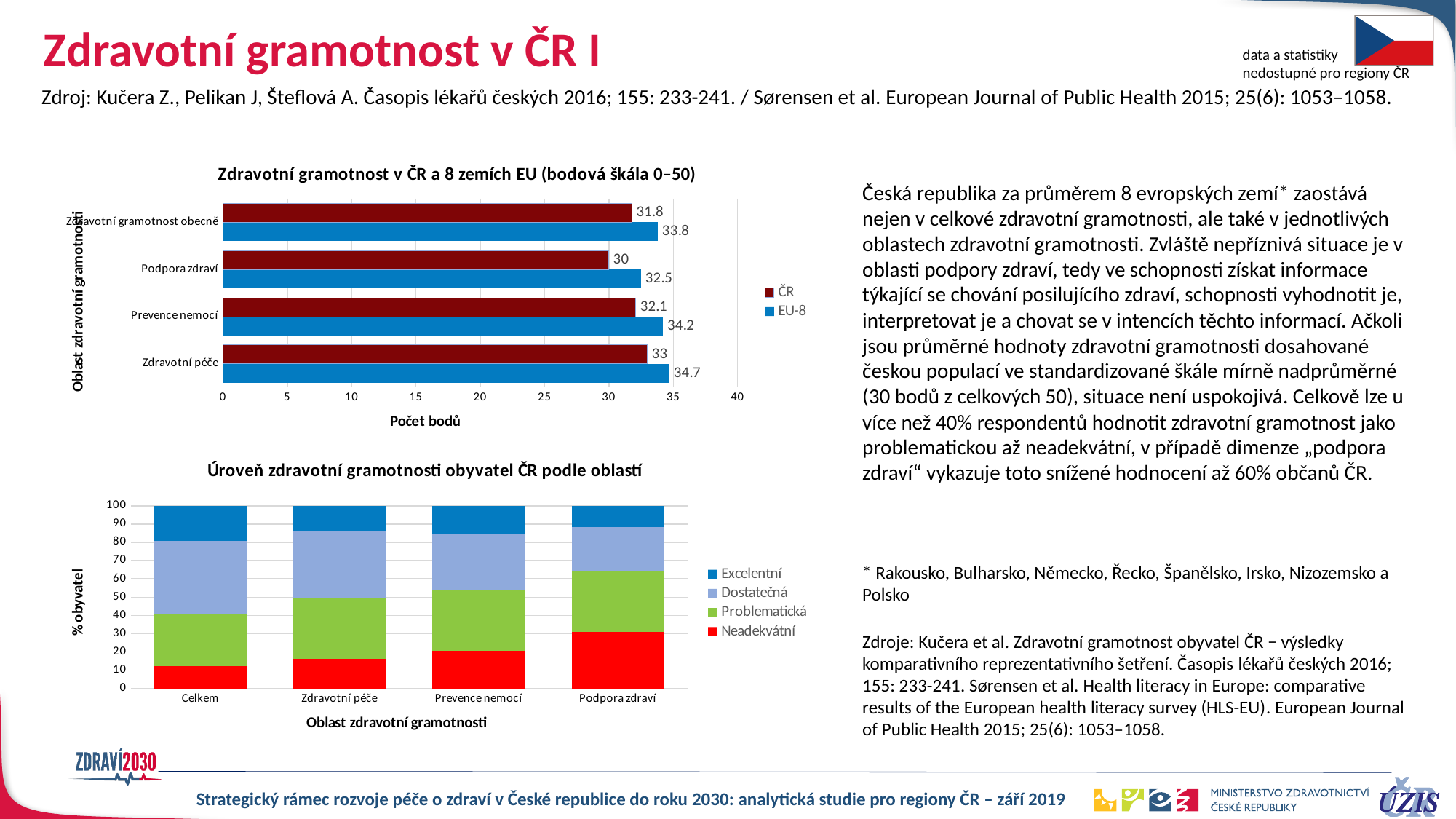
In the chart 'Zdravotní gramotnost v ČR a 8 zemích EU', is the ČR value for Zdravotní péče larger or smaller than the EU-8 value? smaller In the chart 'Úroveň zdravotní gramotnosti obyvatel ČR podle oblastí', which colour represents the Problematická series? green How many series does the legend of the chart 'Zdravotní gramotnost v ČR a 8 zemích EU' list? 2 In the chart 'Úroveň zdravotní gramotnosti obyvatel ČR podle oblastí', is the Neadekvátní value for Podpora zdraví greater or less than 20? greater In the chart 'Zdravotní gramotnost v ČR a 8 zemích EU', what is the difference between the EU-8 and ČR values for Podpora zdraví? 2.5 In the chart 'Zdravotní gramotnost v ČR a 8 zemích EU', what is the EU-8 value for Zdravotní péče? 34.7 In the chart 'Zdravotní gramotnost v ČR a 8 zemích EU', what is the ČR value for Podpora zdraví? 30 In the chart 'Zdravotní gramotnost v ČR a 8 zemích EU', what is the EU-8 value for Prevence nemocí? 34.2 In the chart 'Zdravotní gramotnost v ČR a 8 zemích EU', which category has the lowest ČR value? Podpora zdraví In the chart 'Zdravotní gramotnost v ČR a 8 zemích EU', which category has the highest EU-8 value? Zdravotní péče What type of chart is 'Úroveň zdravotní gramotnosti obyvatel ČR podle oblastí'? stacked bar chart How many categories are shown on the x axis of the chart 'Úroveň zdravotní gramotnosti obyvatel ČR podle oblastí'? 4